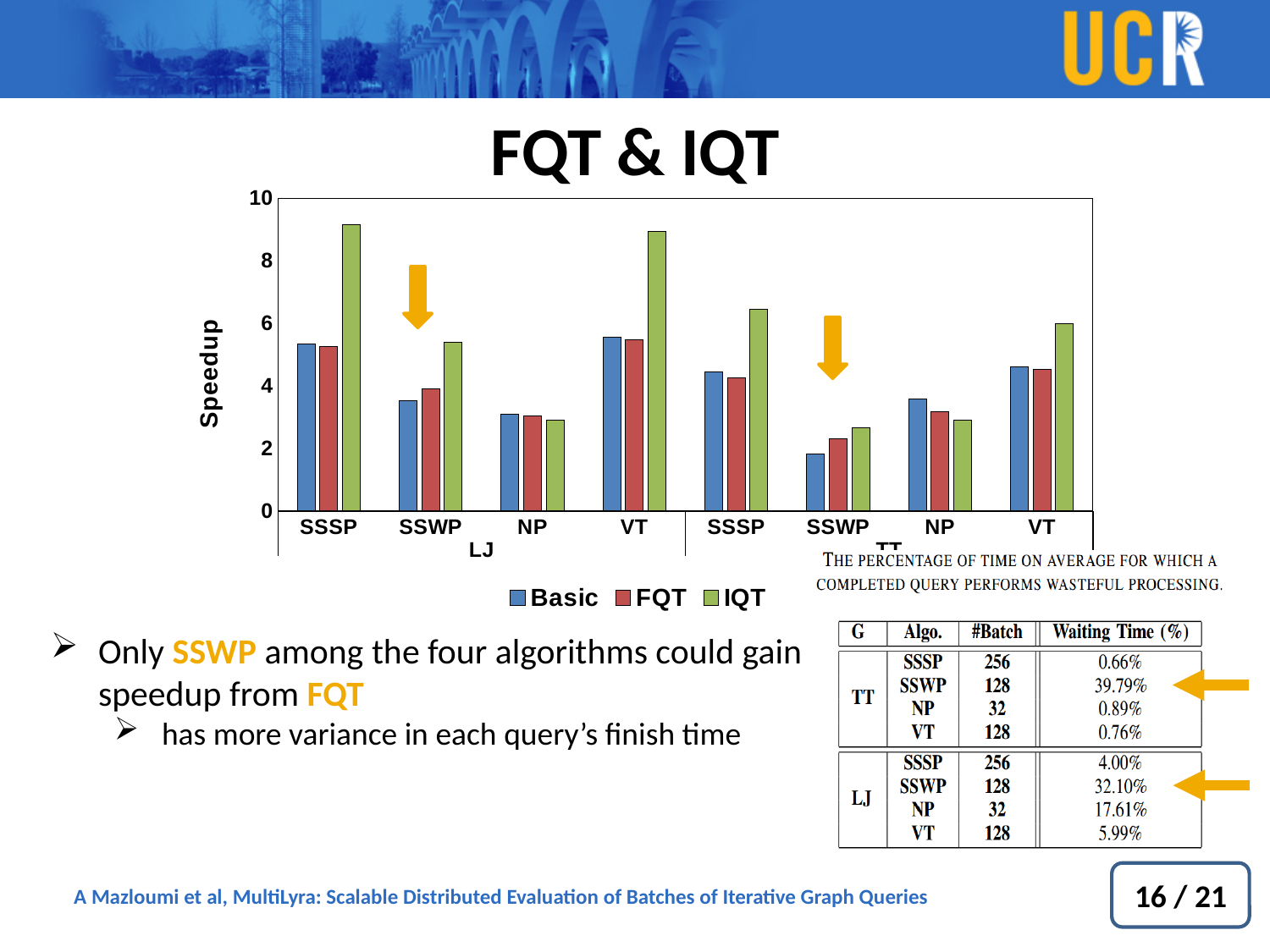
Which category has the lowest Basic value in the chart? SSWP on TT How many algorithm categories are plotted along the x axis of the chart (across both LJ and TT)? 8 For SSSP on LJ, which is larger, the Basic value or the IQT value? IQT Is the Basic value for VT on LJ greater or less than 4? greater What is the label on the vertical axis of the chart? Speedup Is the IQT value for SSSP on LJ greater or less than 8? greater How many series does the chart legend list? 3 What are the series names listed in the chart legend? Basic, FQT, IQT Is the IQT value for NP on LJ greater or less than 4? less What kind of chart is shown on the slide? bar chart For SSWP on TT, which is larger, the Basic value or the FQT value? FQT